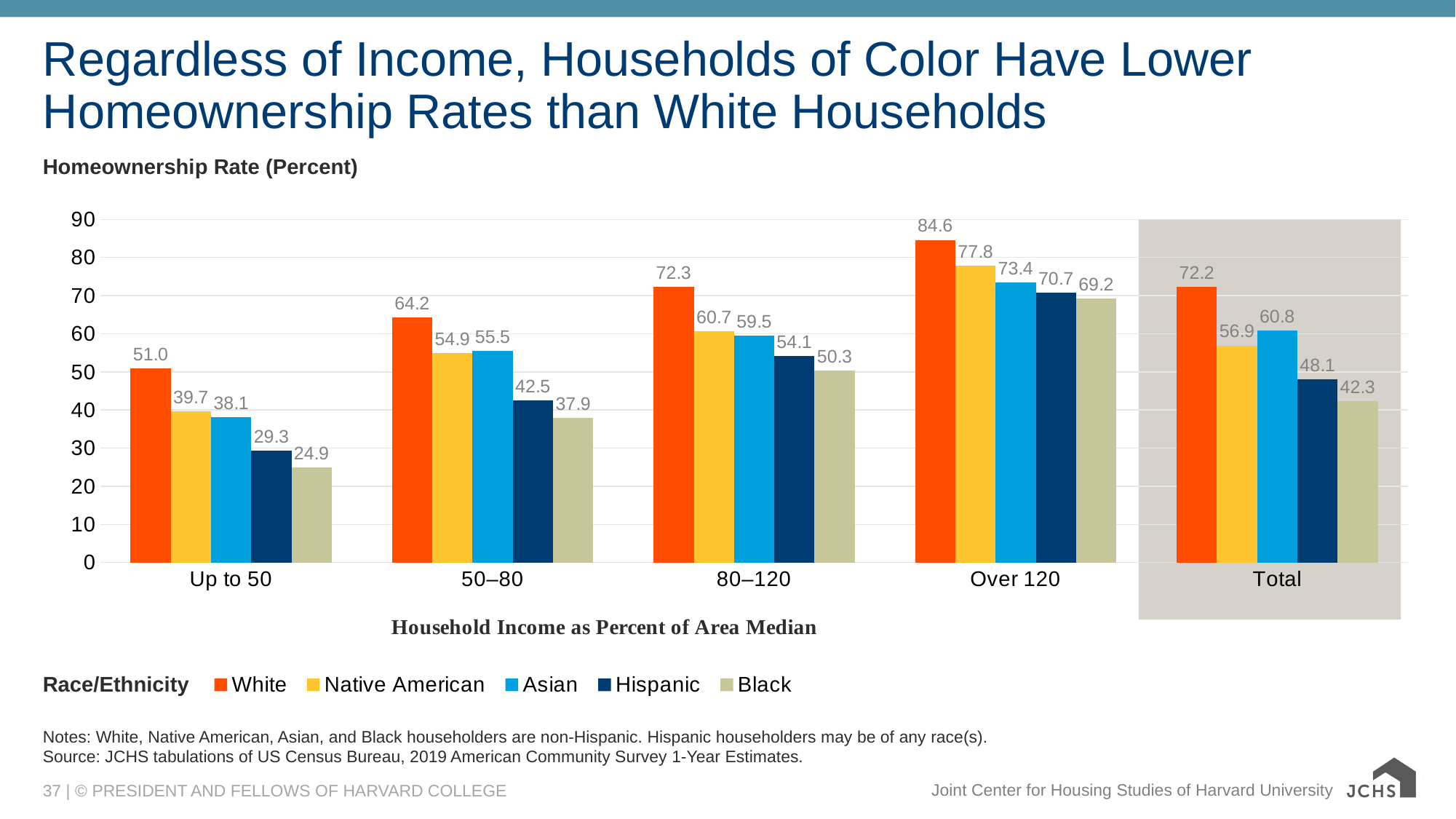
Is the Hispanic homeownership rate in the Over 120 income group greater or less than 60? greater How many income categories are shown on the x axis? 5 What is the difference between the White and Black homeownership rates in the Total category? 29.9 What kind of chart is shown on the slide? Bar chart Which race/ethnicity has the lowest homeownership rate in the Up to 50 income group? Black Which race/ethnicity has the highest homeownership rate in the Over 120 income group? White How many race/ethnicity series does the legend list? 5 What is the homeownership rate for Black households in the Total category? 42.3 What is the homeownership rate for White households in the Up to 50 income group? 51.0 Do the White homeownership rates rise or fall from Up to 50 through Over 120? Rise Which is larger in the 50–80 income group: the Native American rate or the Asian rate? Asian What is the homeownership rate for Hispanic households in the 80–120 income group? 54.1